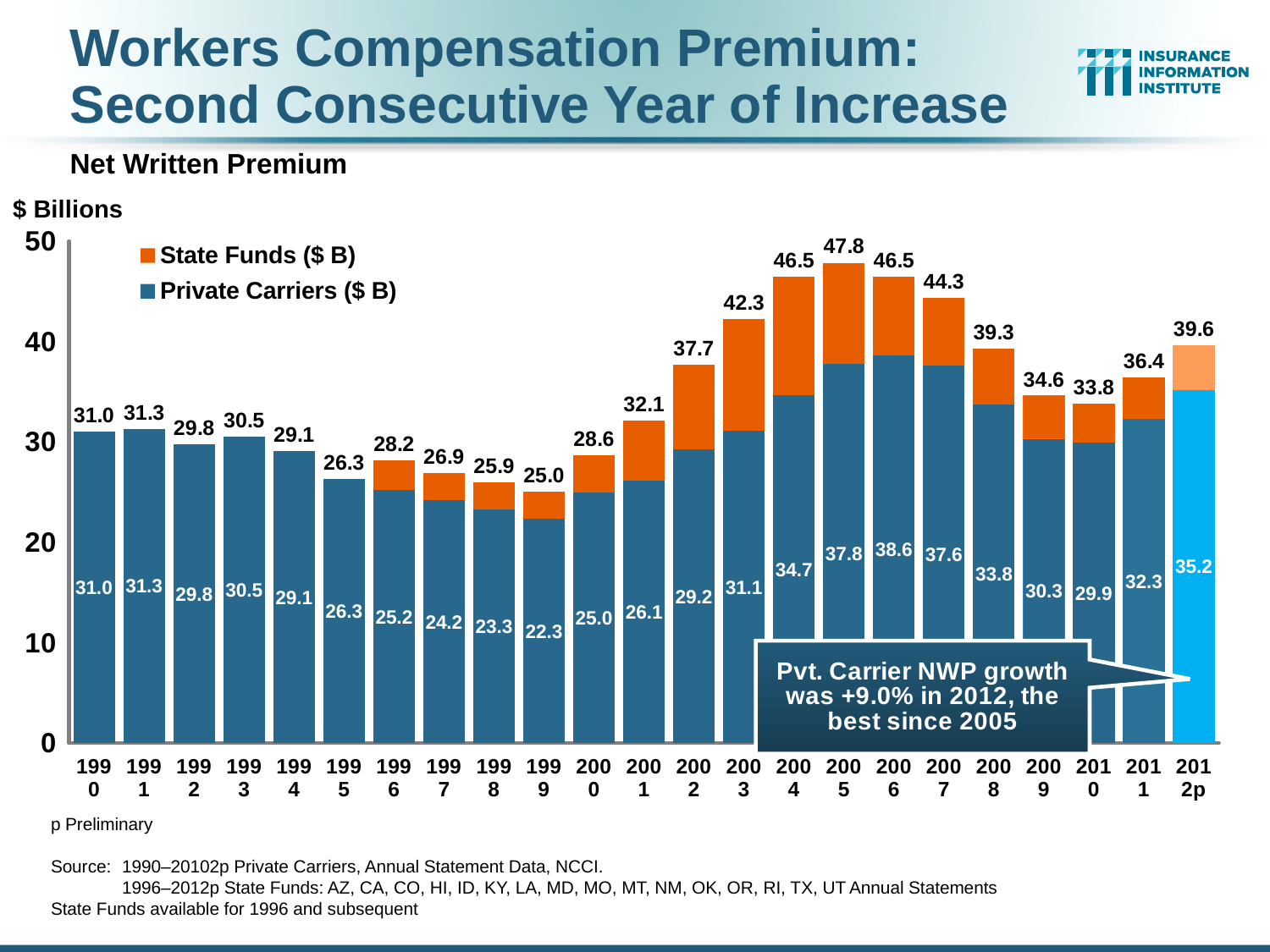
Which year has the highest total net written premium? 2005 What is the difference between the total for 2012p and the Private Carriers value for 2012p? 4.4 How many years are shown on the x axis? 23 What is the Private Carriers value shown for 2012p? 35.2 Which is larger, the total for 2004 or the total for 2006? They are equal (46.5) Which year has the lowest total net written premium? 1999 Is the total for 2003 greater or less than 40? greater What kind of chart is this? Stacked bar chart What is the total net written premium shown for 2005? 47.8 What is the Private Carriers value shown for 1999? 22.3 How many series does the legend list? 2